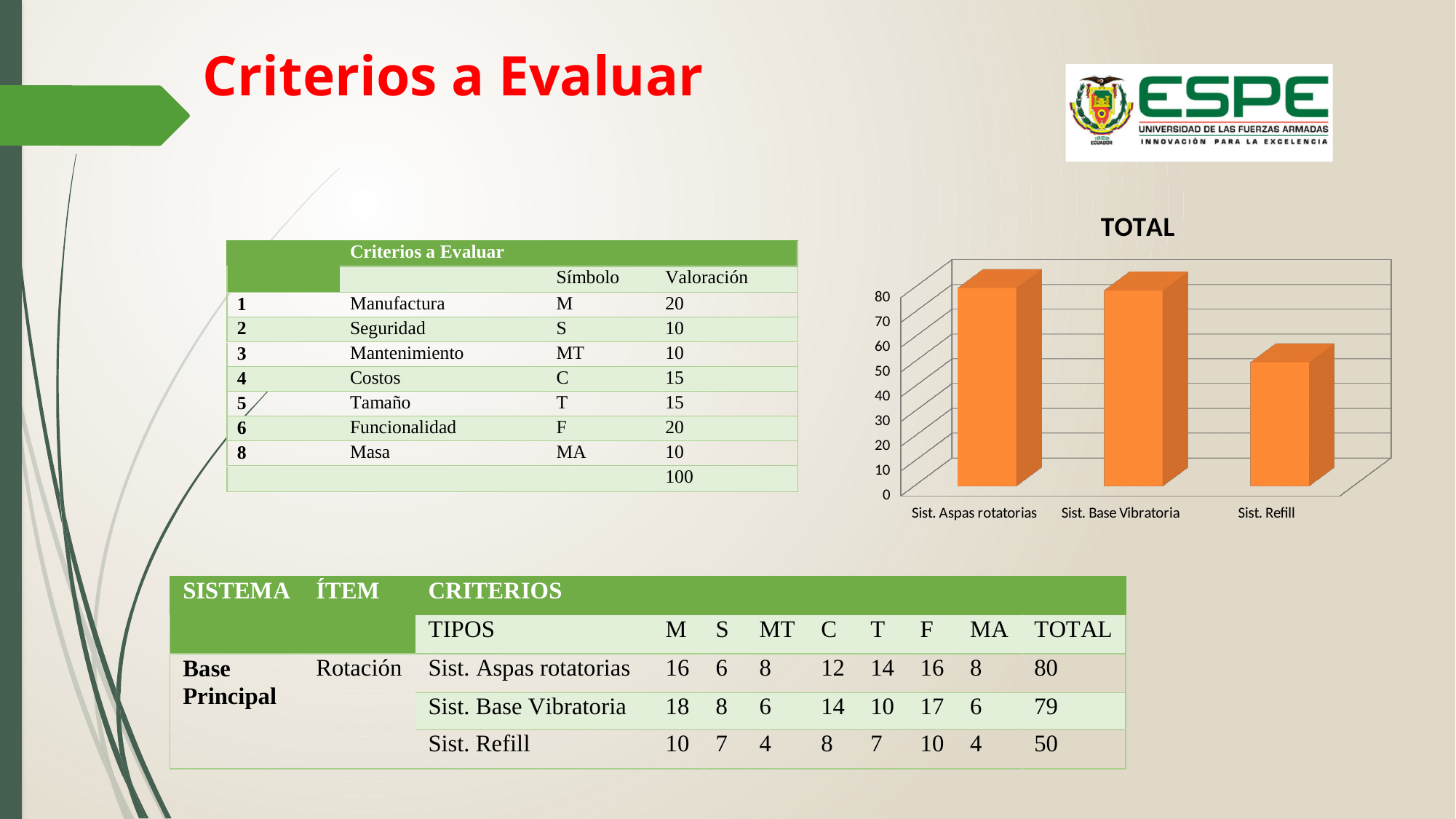
How many categories are plotted in the TOTAL chart? 3 In the TOTAL chart, which is larger: Sist. Base Vibratoria or Sist. Refill? Sist. Base Vibratoria What is the TOTAL value for Sist. Aspas rotatorias? 80 Is the value for Sist. Base Vibratoria in the TOTAL chart greater or less than 60? greater What colour are the bars in the TOTAL chart? orange What is the title of the chart? TOTAL Is the value for Sist. Aspas rotatorias in the TOTAL chart greater or less than 70? greater What is the TOTAL value for Sist. Refill? 50 Which category has the lowest value in the TOTAL chart? Sist. Refill In the TOTAL chart, which is larger: Sist. Aspas rotatorias or Sist. Refill? Sist. Aspas rotatorias Is the value for Sist. Refill in the TOTAL chart greater or less than 60? less What kind of chart is shown on the slide? bar chart